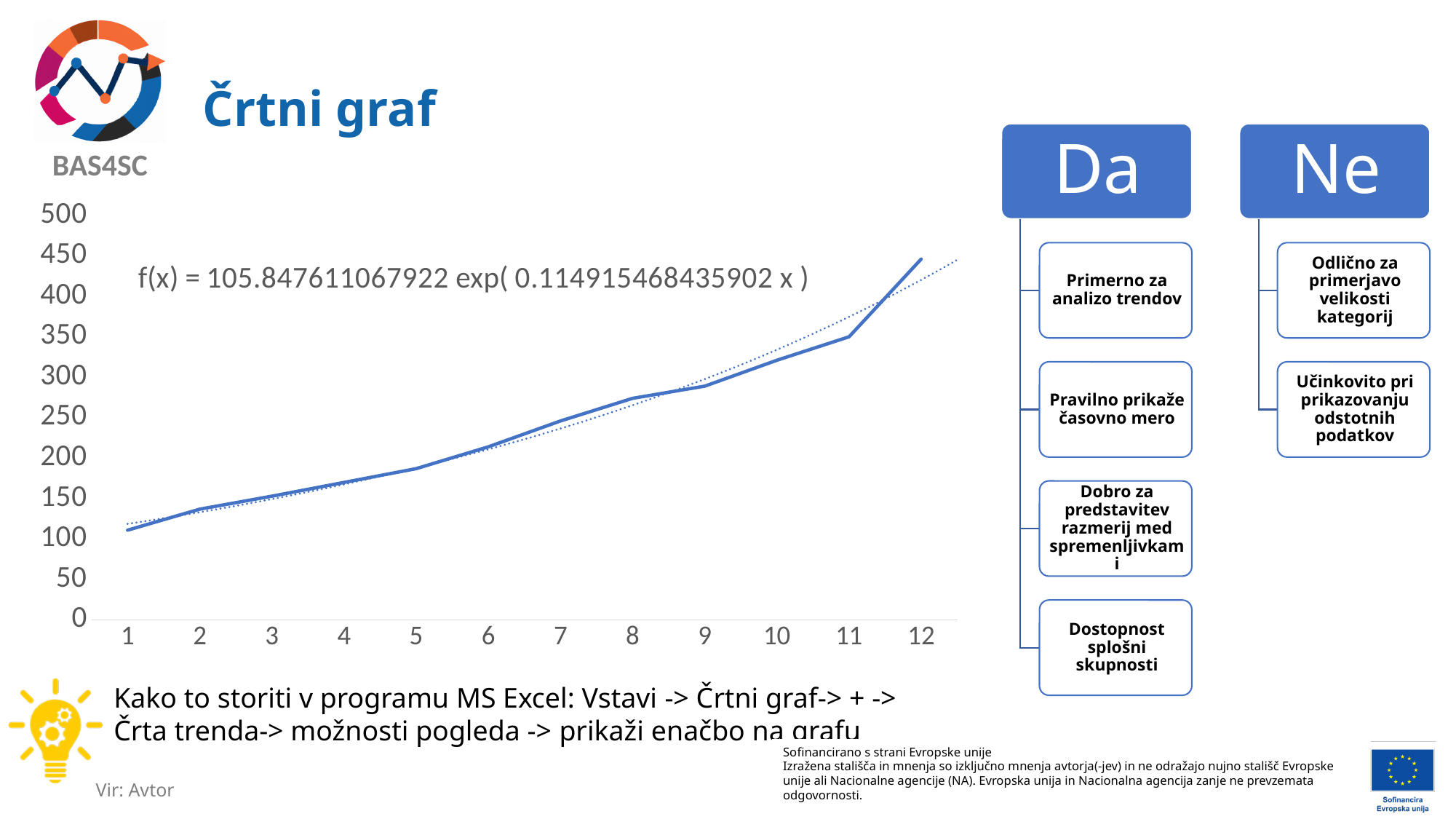
At which x value is the plotted line lowest? 1 What trendline equation is displayed on the chart? f(x) = 105.847611067922 exp( 0.114915468435902 x ) Is the value at x = 1 greater or less than 150? less Is the value at x = 8 greater or less than 250? greater Is the value at x = 12 greater or less than 400? greater How many points are plotted along the x axis of the line chart? 12 Which has the larger value, x = 10 or x = 5? 10 What kind of chart is shown on the slide? line chart At which x value is the plotted line highest? 12 Do the values in the line chart rise or fall as x goes from 1 to 12? rise What is the highest tick value shown on the y axis of the chart? 500